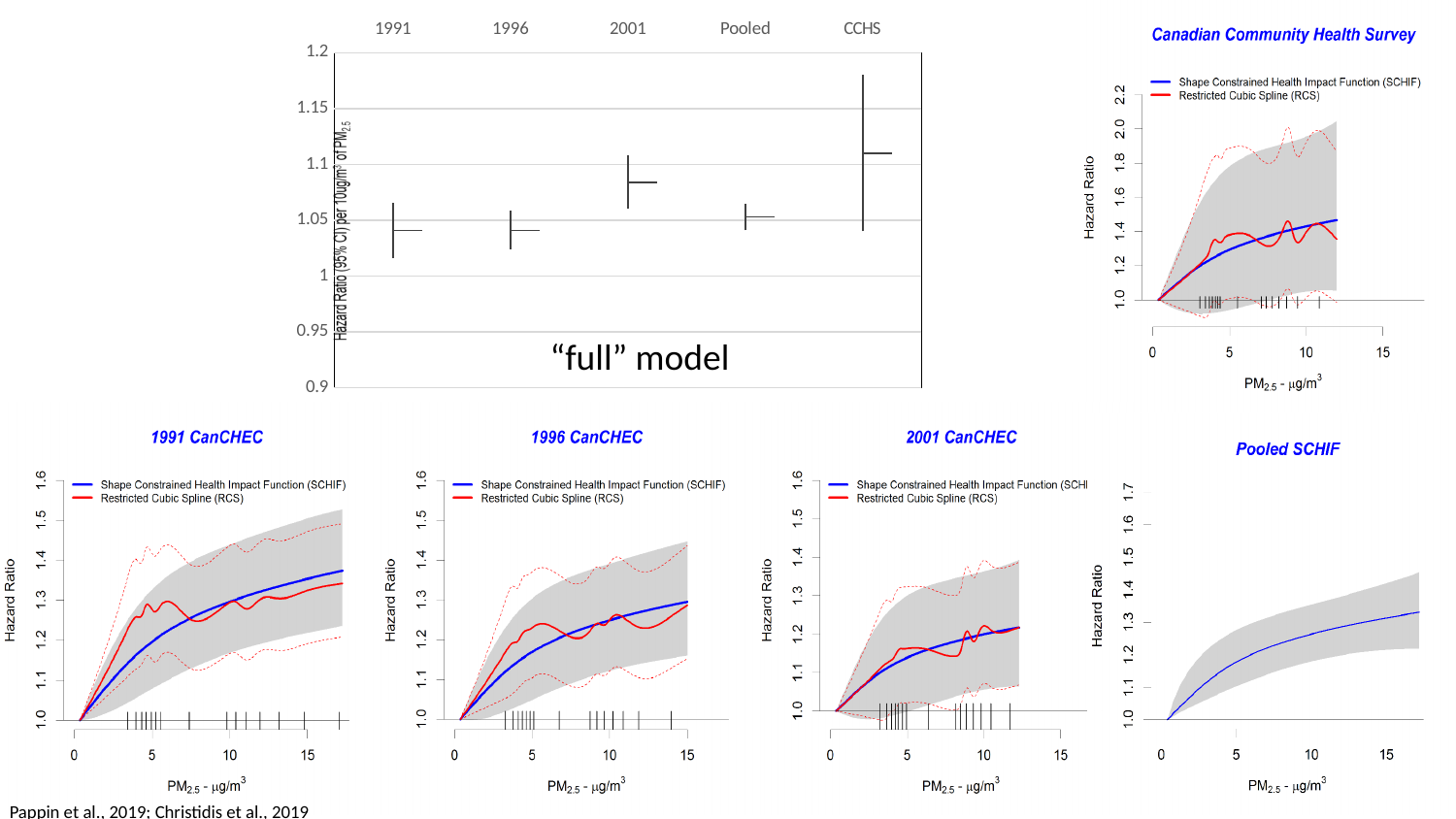
In the 1996 CanCHEC chart, what is the label of the red line in the legend? Restricted Cubic Spline (RCS) In the "full" model chart at the top left, is the hazard ratio point estimate for 2001 greater or less than 1.05? greater In the "full" model chart at the top left, what is the highest value shown on the vertical axis? 1.2 What kind of chart is the Canadian Community Health Survey chart at the top right? line chart In the "full" model chart at the top left, which category has the highest hazard ratio point estimate? CCHS In the "full" model chart at the top left, is the hazard ratio point estimate for CCHS greater or less than 1.05? greater In the 2001 CanCHEC chart, does the blue SCHIF line rise or fall as PM2.5 increases? rise In the Pooled SCHIF chart, does the hazard ratio rise or fall as PM2.5 increases along the x axis? rise In the "full" model chart at the top left, which has the larger hazard ratio point estimate, 2001 or Pooled? 2001 In the 1991 CanCHEC chart, how many series does the legend list? 2 In the "full" model chart at the top left, how many categories are shown along the top of the chart? 5 In the "full" model chart at the top left, is the hazard ratio point estimate for 1991 greater or less than 1? greater